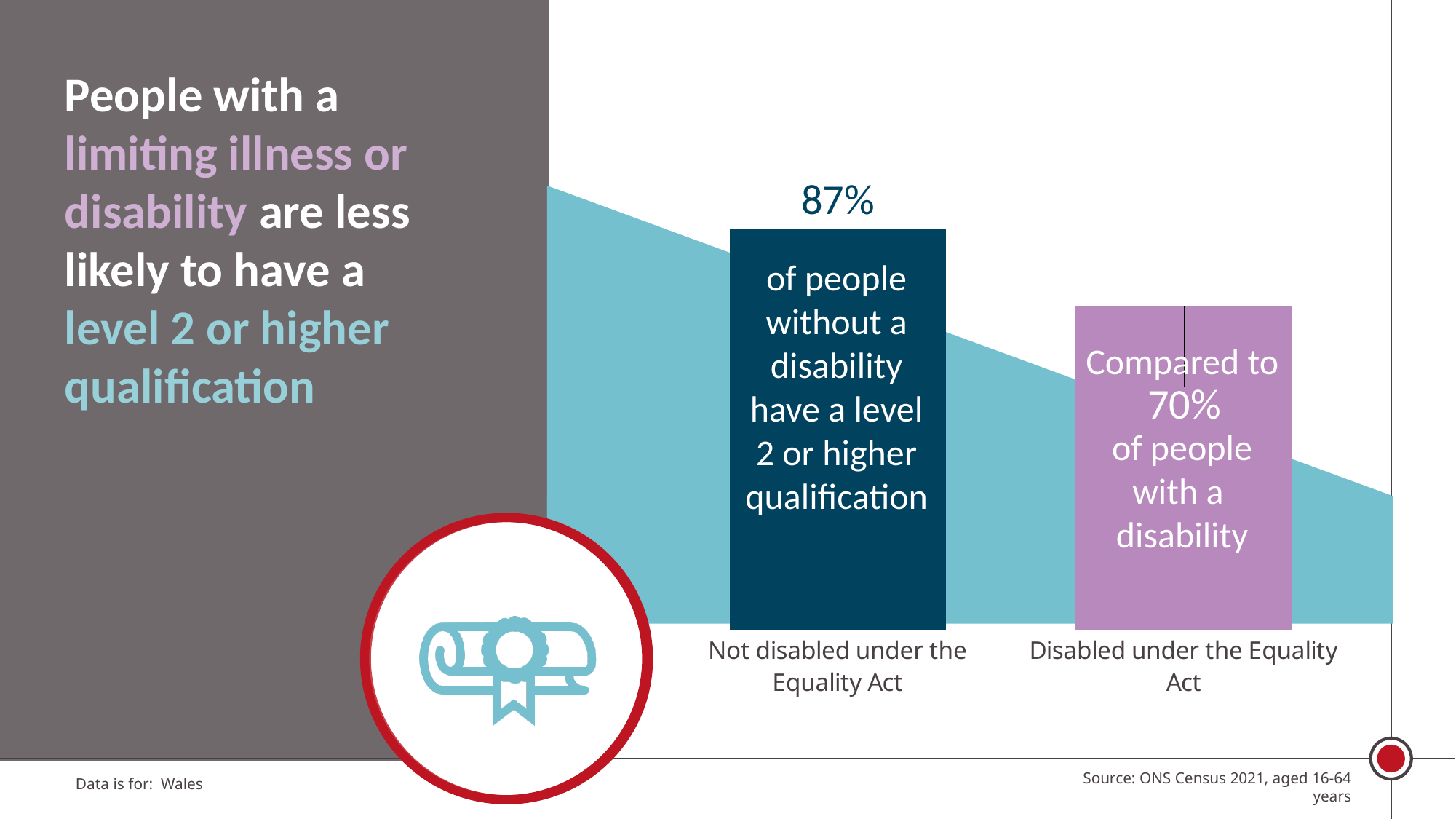
Which category has the lower value? Disabled under the Equality Act What percentage of people not disabled under the Equality Act have a level 2 or higher qualification? 87% Do the values rise or fall from left to right across the categories? fall What is the difference in percentage points between the not disabled and disabled categories? 17 percentage points Which category has the higher value? Not disabled under the Equality Act What kind of chart is shown on the slide? bar chart How many categories are shown in the chart? 2 What percentage of people disabled under the Equality Act have a level 2 or higher qualification? 70% What is the source of the data shown in the chart? ONS Census 2021, aged 16-64 years What colour is the bar for people disabled under the Equality Act? purple Is the value for people not disabled under the Equality Act larger or smaller than the value for people disabled under the Equality Act? larger